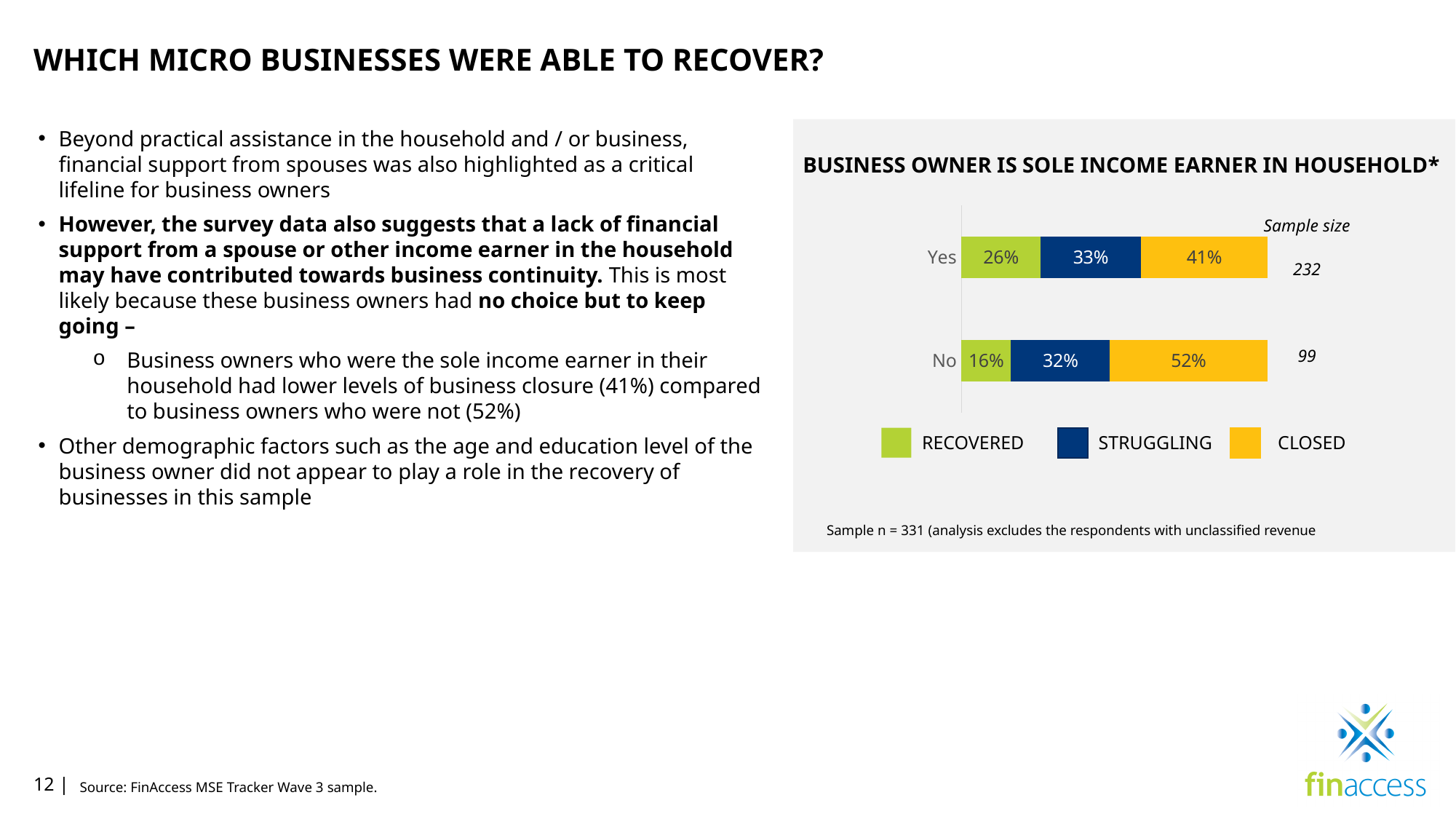
What is the difference in the Recovered percentage between the Yes and No categories? 10% Which category has the higher Closed percentage, Yes or No? No What is the difference in the Closed percentage between the No and Yes categories? 11% What is the title of the chart? BUSINESS OWNER IS SOLE INCOME EARNER IN HOUSEHOLD* How many categories are shown on the chart? 2 What percentage of business owners who were not the sole income earner (No) recovered? 16% How many series does the legend list? 3 What is the sample size for the No category? 99 What percentage of business owners who were the sole income earner in their household (Yes) had closed their business? 41% Which category has the higher Recovered percentage? Yes What is the Struggling share for the Yes category? 33% What type of chart is shown on the slide? Stacked bar chart